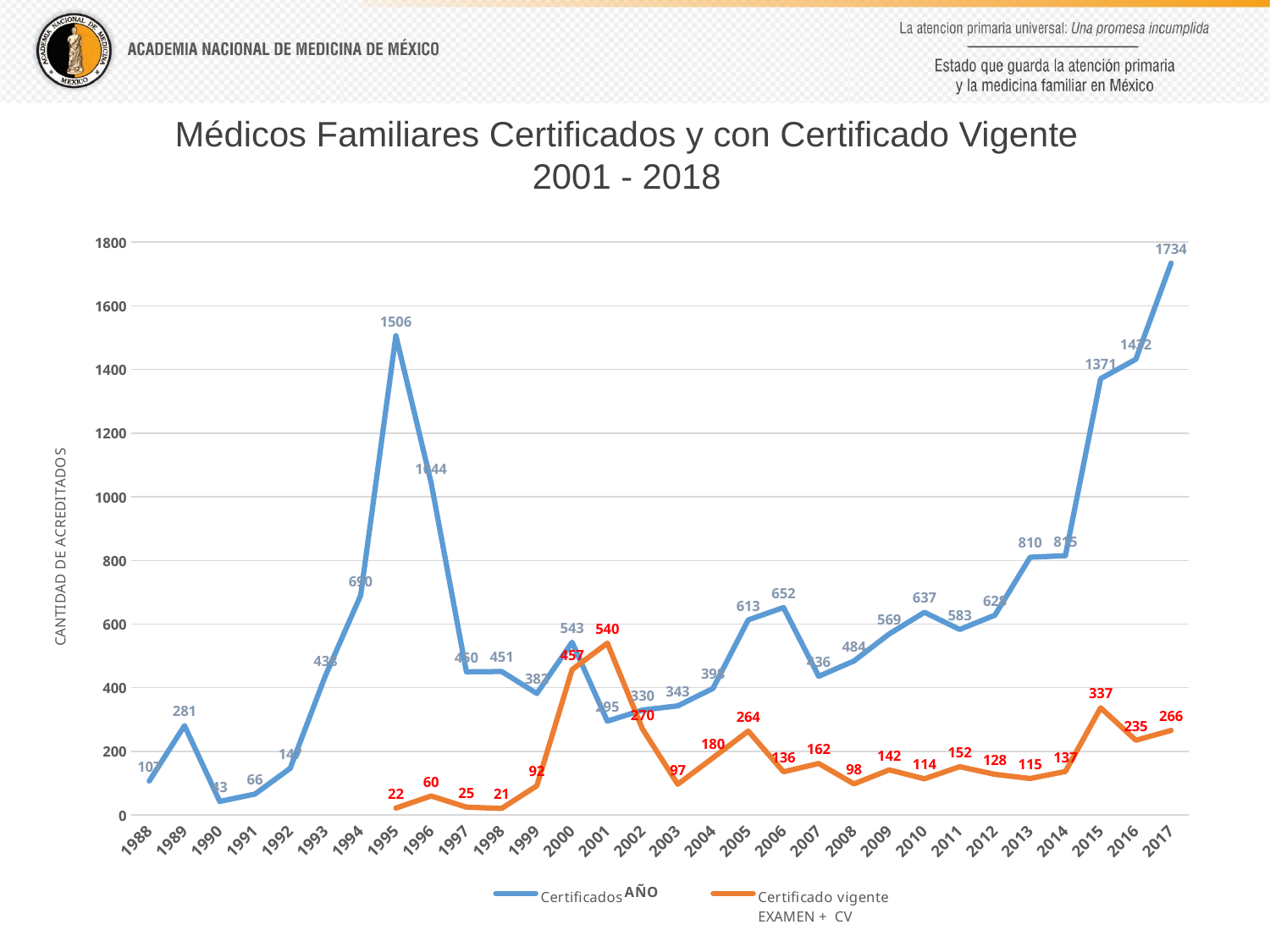
In which year does the Certificado vigente series have its lowest value? 1998 How many series does the legend list? 2 What is the difference between the Certificados values for 2006 and 2005? 39 What kind of chart is shown on the slide? line chart What is the value of the Certificados series in 2017? 1734 In 2015, which series has the larger value, Certificados or Certificado vigente? Certificados What is the difference between the Certificado vigente values for 2015 and 2016? 102 Is the Certificados value for 1996 greater or less than 1000? greater In which year does the Certificado vigente series reach its highest value? 2001 In which year does the Certificados series reach its highest value? 2017 What is the value of the Certificados series in 1995? 1506 What is the value of the Certificado vigente series in 2001? 540